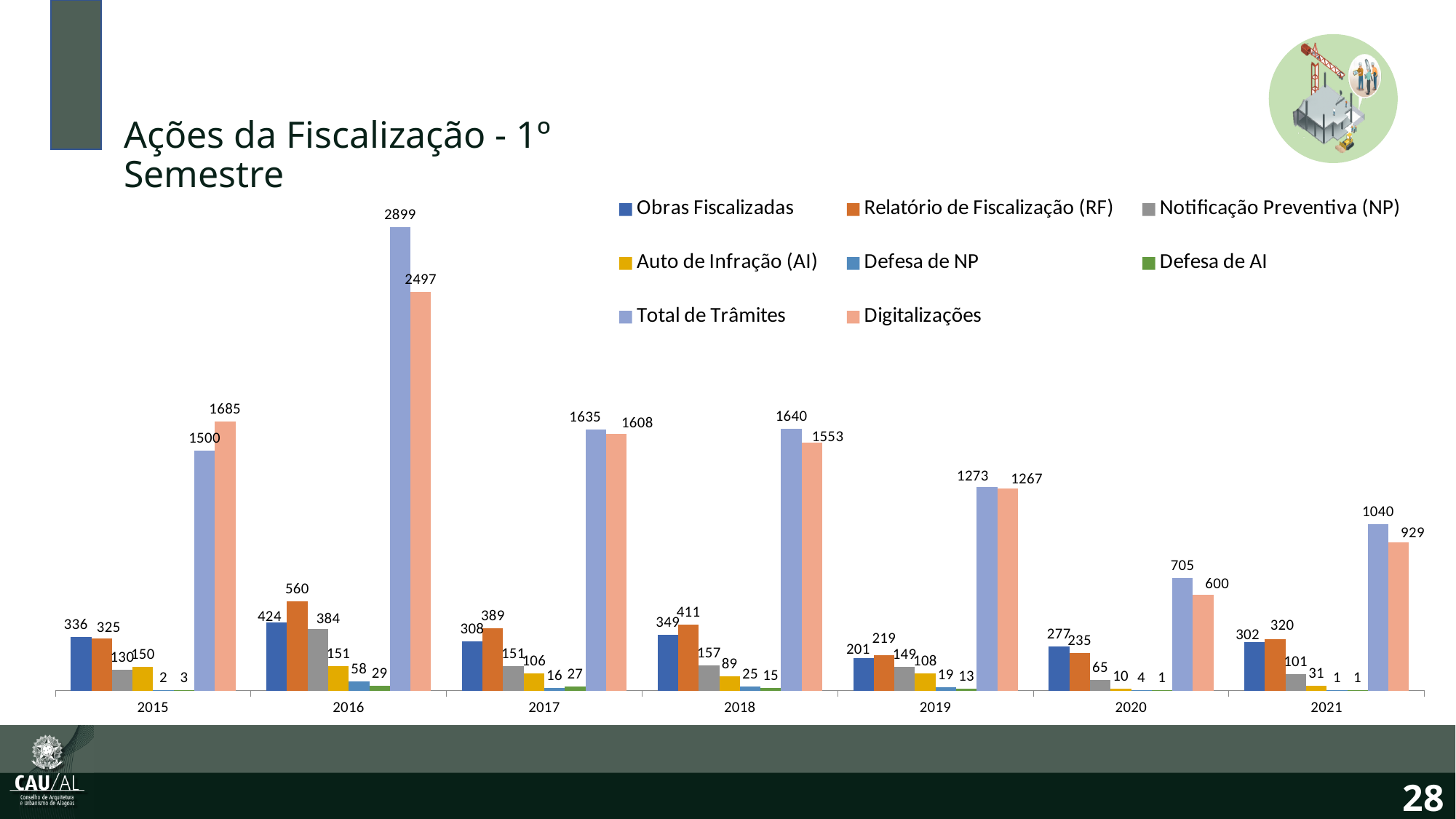
What is the difference between Obras Fiscalizadas in 2016 and in 2015? 88 What is the difference between Total de Trâmites and Digitalizações in 2016? 402 How many years are shown on the x axis? 7 What is the value of Digitalizações in 2021? 929 How many series does the legend list? 8 What is the value of Auto de Infração (AI) in 2019? 108 What kind of chart is shown on the slide? bar chart Does Total de Trâmites rise or fall from 2016 to 2020? fall In which year is Total de Trâmites highest? 2016 What is the value of Total de Trâmites in 2016? 2899 In 2020, which is larger: Obras Fiscalizadas or Relatório de Fiscalização (RF)? Obras Fiscalizadas In which year is Total de Trâmites lowest? 2020